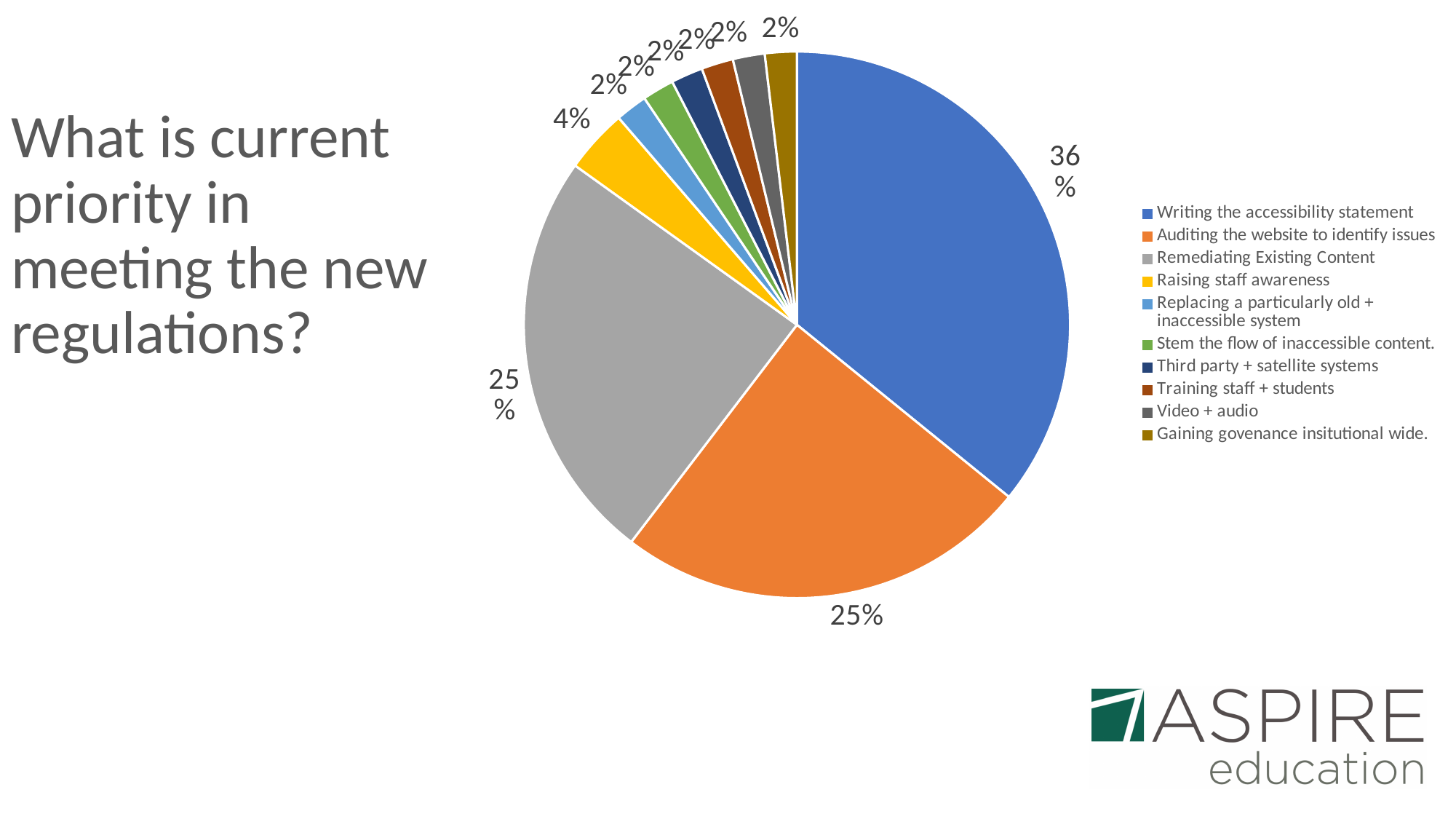
What colour is the slice for "Auditing the website to identify issues"? orange What type of chart is shown on the slide? pie chart What share of the pie does "Raising staff awareness" have? 4% What share of the pie does "Writing the accessibility statement" have? 36% What is the difference between the share for "Writing the accessibility statement" and the share for "Remediating Existing Content"? 11% What share of the pie does "Auditing the website to identify issues" have? 25% Which category has the largest slice of the pie? Writing the accessibility statement What is the difference between the share for "Writing the accessibility statement" and the share for "Raising staff awareness"? 32% How many categories does the legend list? 10 Which is larger: the share for "Raising staff awareness" or the share for "Third party + satellite systems"? Raising staff awareness